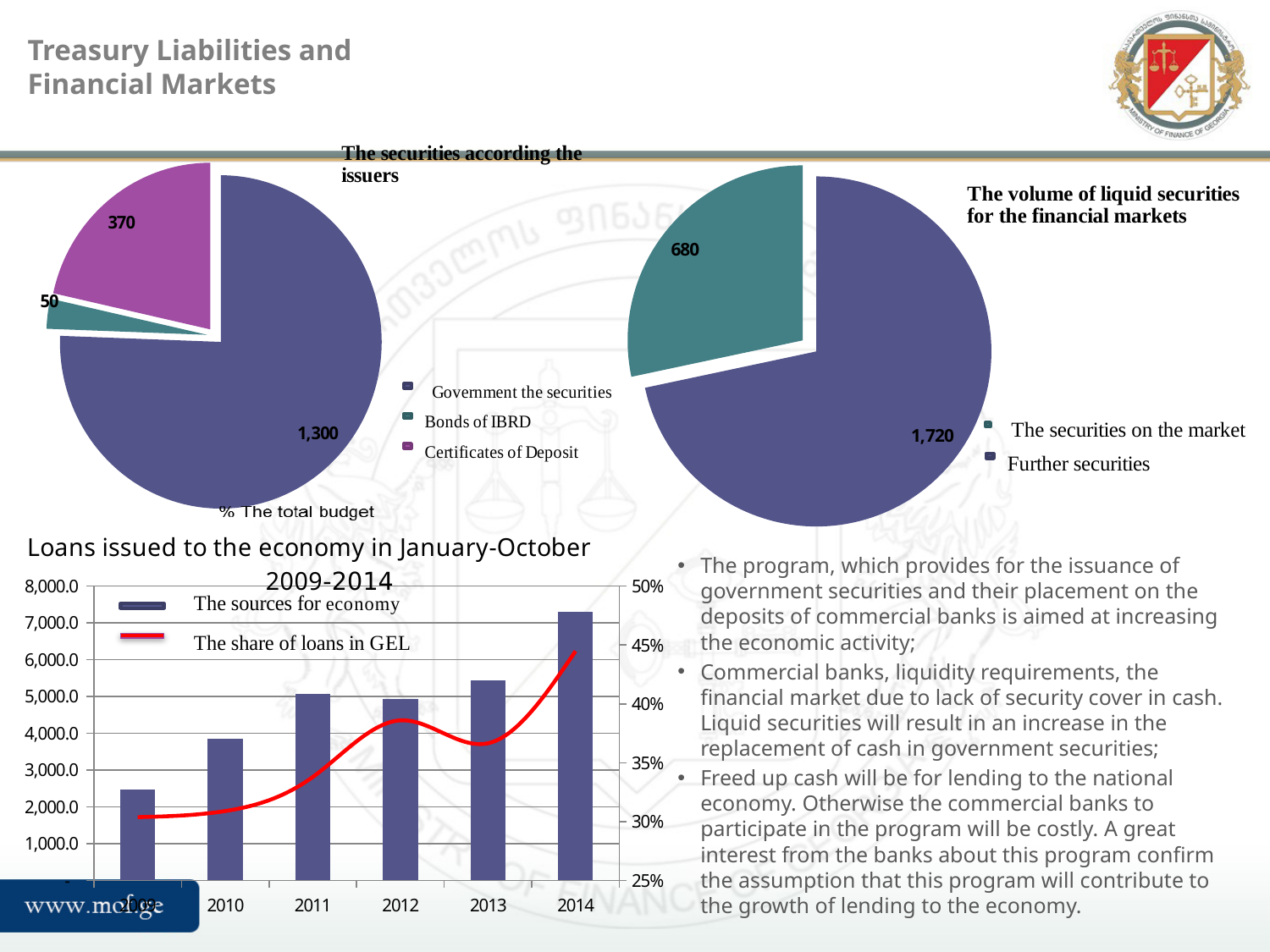
In the pie chart 'The securities according the issuers', which category has the smallest slice? Bonds of IBRD In the pie chart 'The volume of liquid securities for the financial markets', which category is larger? Further securities In the chart 'Loans issued to the economy in January-October 2009-2014', is the bar for 2014 greater or less than 7,000.0? greater In the pie chart 'The securities according the issuers', what is the difference between Government the securities and Certificates of Deposit? 930 In the chart 'Loans issued to the economy in January-October 2009-2014', how many years are shown on the x axis? 6 In the chart 'Loans issued to the economy in January-October 2009-2014', which year has the shortest bar? 2009 In the chart 'Loans issued to the economy in January-October 2009-2014', how many series does the legend list? 2 In the pie chart 'The volume of liquid securities for the financial markets', what is the value for The securities on the market? 680 In the pie chart 'The securities according the issuers', what is the value for Certificates of Deposit? 370 In the pie chart 'The volume of liquid securities for the financial markets', what is the total of the two slices? 2,400 In the chart 'Loans issued to the economy in January-October 2009-2014', which year has the tallest bar? 2014 In the pie chart 'The securities according the issuers', what is the value for Government the securities? 1,300